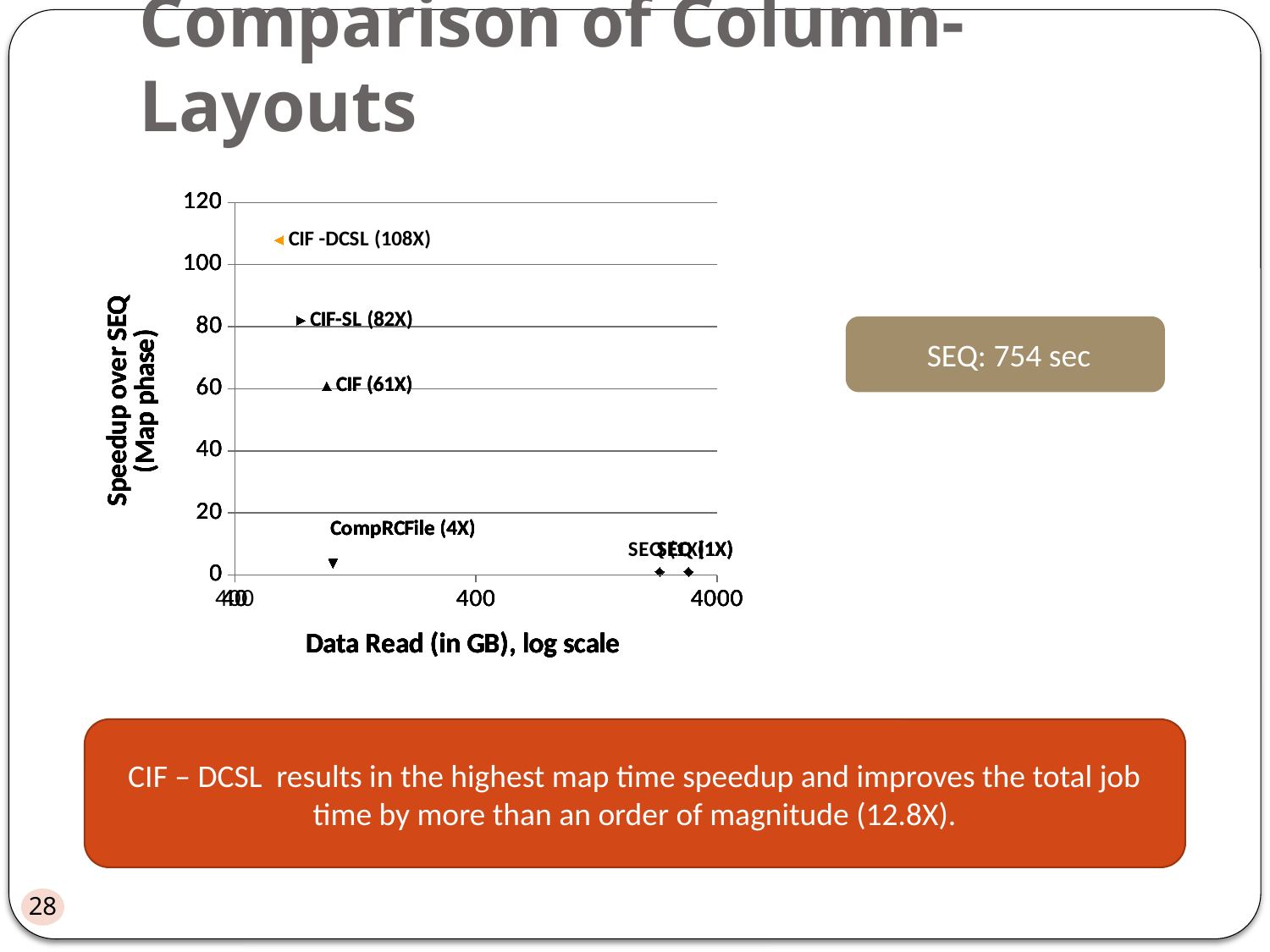
What is the difference in speedup between CIF-DCSL (108X) and CIF-SL (82X)? 26X Which layout has the highest speedup over SEQ in the chart? CIF-DCSL Which labeled layout has the lowest speedup over SEQ in the chart? SEQ Is the speedup value for CIF-DCSL greater or less than 100? greater What is the label of the y-axis of the chart? Speedup over SEQ (Map phase) What is the speedup over SEQ for CIF as labeled on the chart? 61X What kind of chart is shown on the slide? Scatter chart Which has a larger speedup over SEQ, CIF-SL or CIF? CIF-SL What is the speedup over SEQ for CIF-SL as labeled on the chart? 82X What is the label of the x-axis of the chart? Data Read (in GB), log scale What is the speedup over SEQ for CIF-DCSL as labeled on the chart? 108X What is the speedup over SEQ for CompRCFile as labeled on the chart? 4X